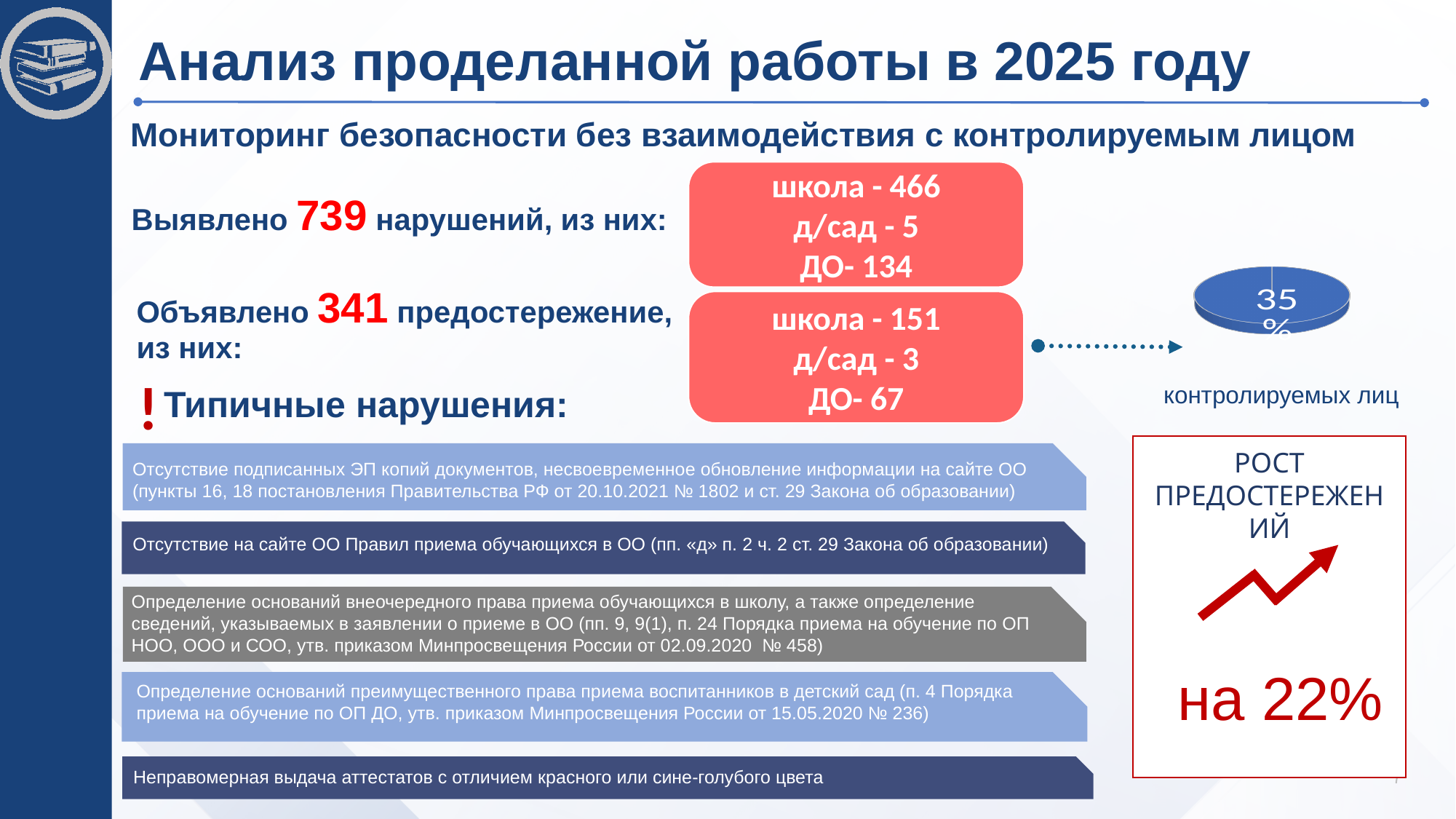
Is the value labelled on the pie chart greater or less than 50%? less What caption text appears directly below the pie chart? контролируемых лиц What colour is the pie chart? blue What percentage value is printed on the pie chart? 35% What kind of chart is shown on the right side of the slide, next to the dotted arrow? pie chart